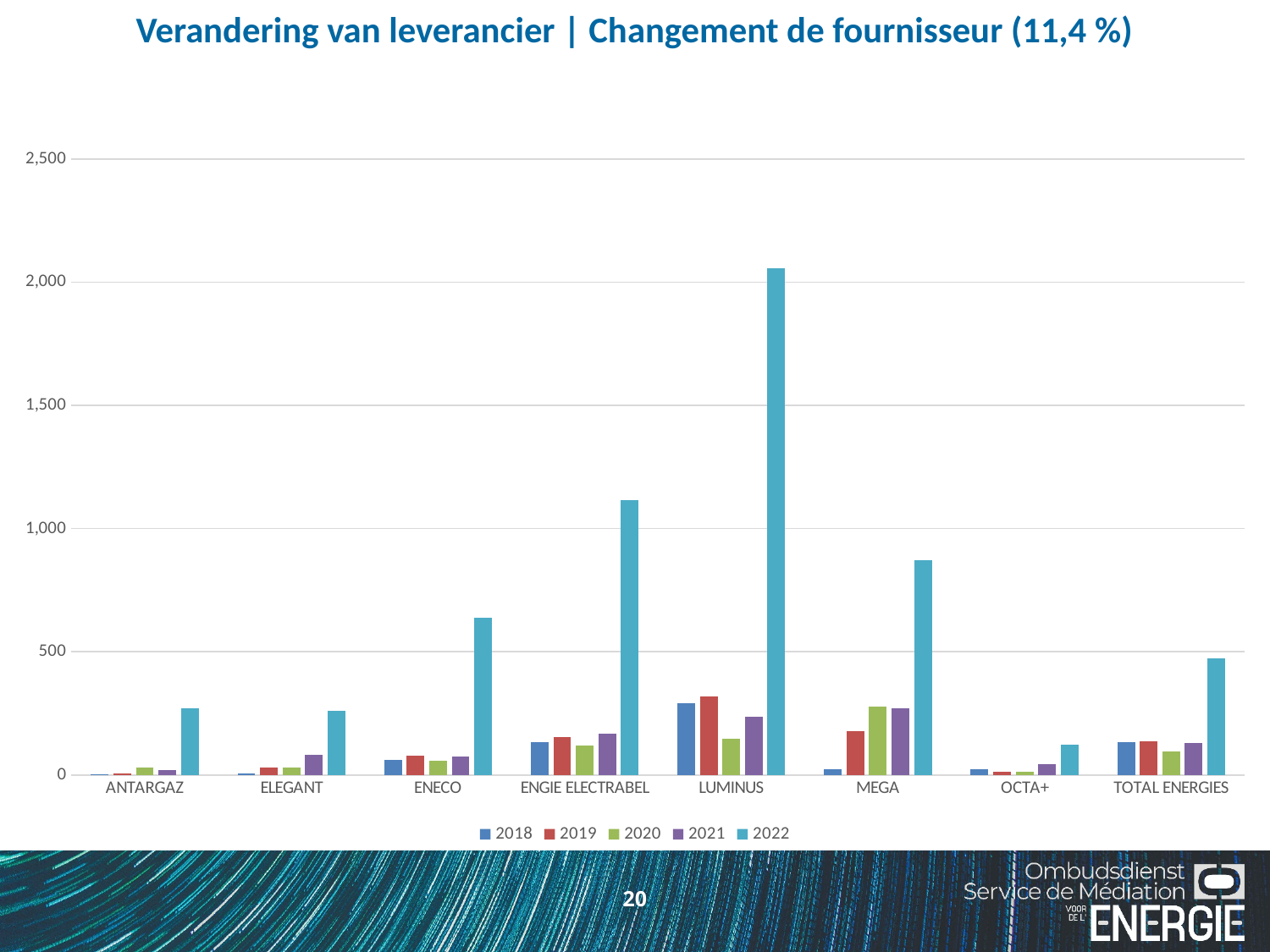
How many suppliers are shown on the x axis of the chart? 8 Which is larger: the 2022 value for ENGIE ELECTRABEL or the 2022 value for MEGA? ENGIE ELECTRABEL Which supplier has the lowest 2022 bar in the chart? OCTA+ What kind of chart is shown on the slide? bar chart How many series does the legend of the chart list? 5 Is the 2022 value for MEGA greater or less than 1,000? less Is the 2022 value for LUMINUS greater or less than 2,000? greater Which supplier has the highest bar in the chart? LUMINUS Which year's series has the tallest bar for every supplier in the chart? 2022 Is the 2022 value for ENECO greater or less than 500? greater What percentage is shown in parentheses in the chart title? 11,4 %